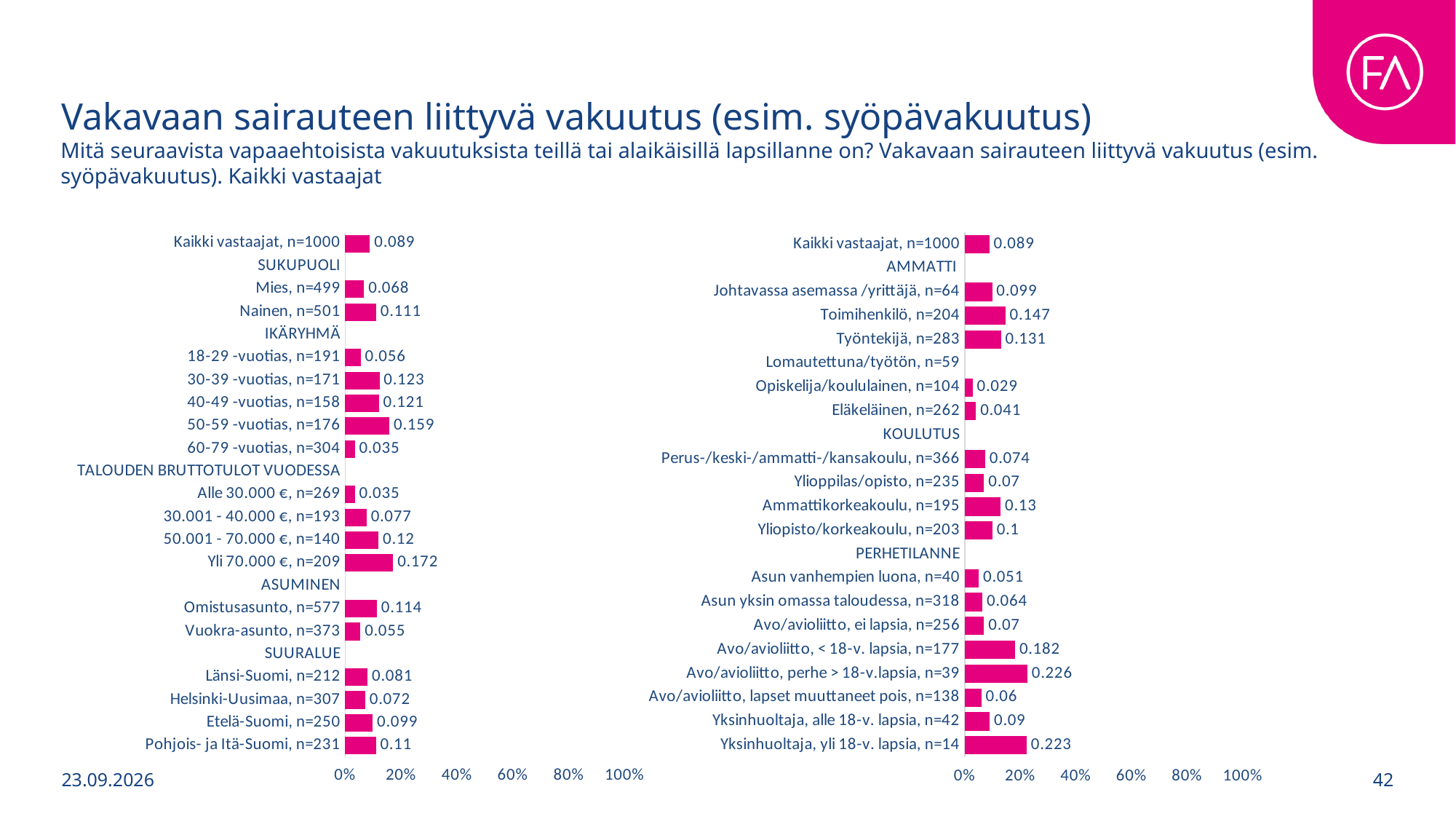
In the left chart, what is the value for Kaikki vastaajat, n=1000? 0.089 In the left chart, what is the difference between the values for Nainen, n=501 and Mies, n=499? 0.043 In the left chart, which category has the highest value? Yli 70.000 €, n=209 In the right chart, what is the value for Toimihenkilö, n=204? 0.147 In the left chart, what is the value for Nainen, n=501? 0.111 In the right chart, is the value for Avo/avioliitto, < 18-v. lapsia, n=177 greater or less than 40%? less In the left chart, what is the value for 50-59 -vuotias, n=176? 0.159 What kind of chart is shown on the left side of the slide? bar chart In the right chart, what is the value for Avo/avioliitto, perhe > 18-v.lapsia, n=39? 0.226 In the right chart, which is larger: the value for Ammattikorkeakoulu, n=195 or Yliopisto/korkeakoulu, n=203? Ammattikorkeakoulu, n=195 In the left chart, which is larger: the value for Omistusasunto, n=577 or Vuokra-asunto, n=373? Omistusasunto, n=577 In the right chart, what is the difference between the values for Toimihenkilö, n=204 and Työntekijä, n=283? 0.016